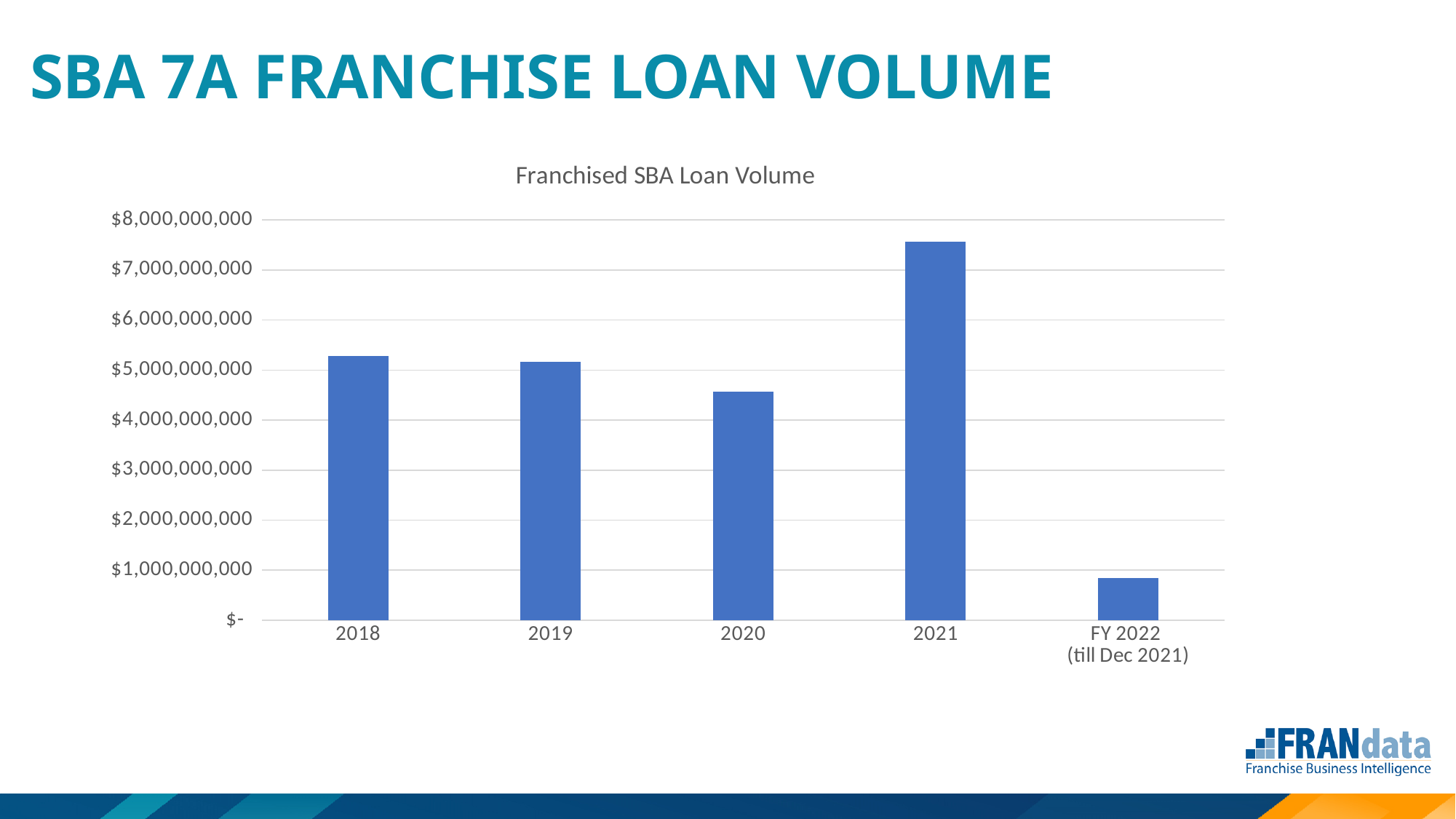
Is the value for 2018 greater or less than $5,000,000,000? greater Which category has the lowest franchised SBA loan volume? FY 2022 (till Dec 2021) What is the title of the chart? Franchised SBA Loan Volume Which is larger, the loan volume for 2018 or for 2020? 2018 Is the value for 2020 greater or less than $5,000,000,000? less Which year has the highest franchised SBA loan volume? 2021 What type of chart is shown on the slide? bar chart Is the value for FY 2022 (till Dec 2021) greater or less than $1,000,000,000? less Which is larger, the loan volume for 2021 or for 2019? 2021 Does the loan volume rise or fall from 2018 to 2020? fall How many bars (categories) are plotted in the chart? 5